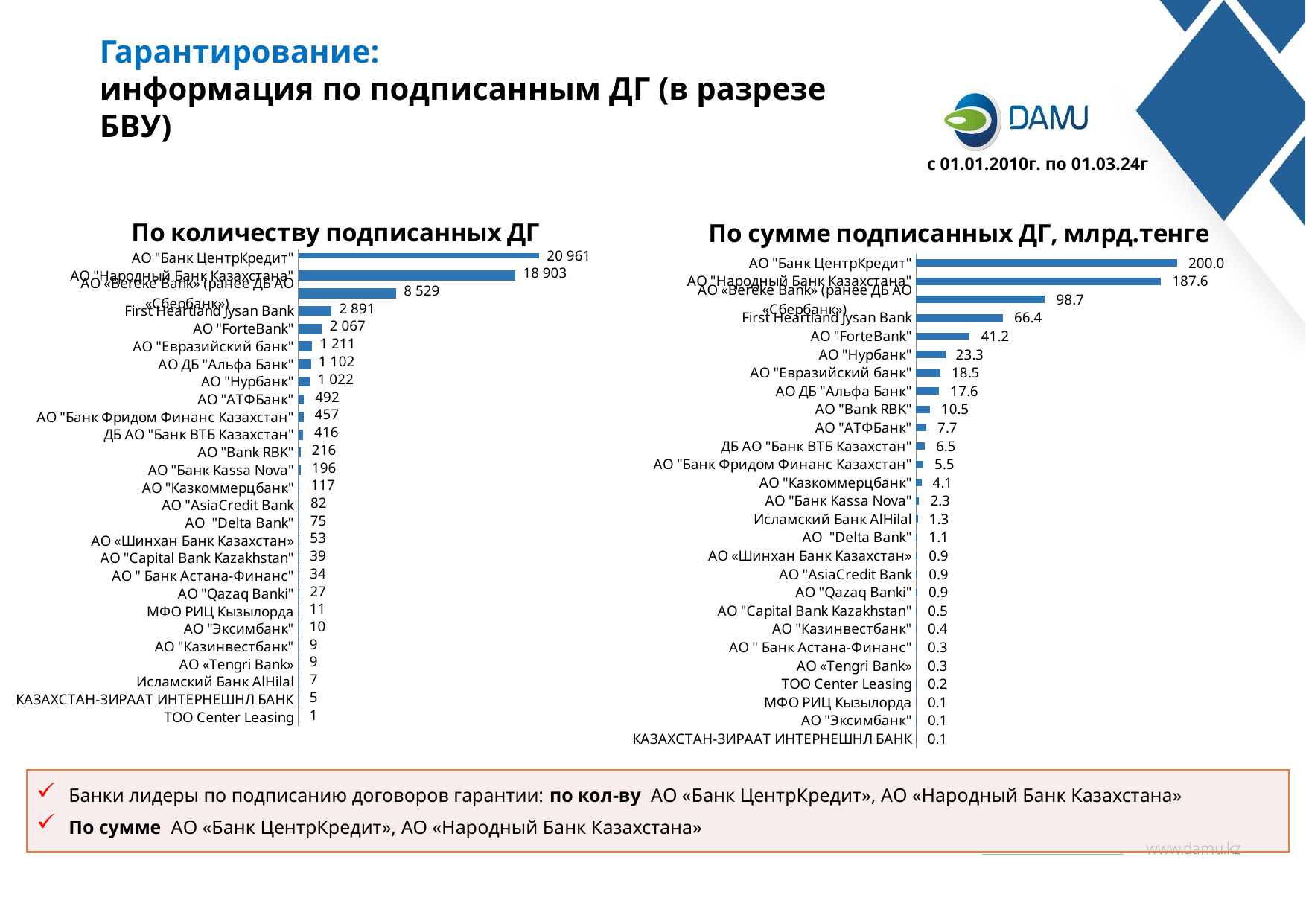
In the chart "По сумме подписанных ДГ, млрд.тенге", what is the difference between First Heartland Jysan Bank and АО "ForteBank"? 25.2 In the chart "По количеству подписанных ДГ", what is the value for АО "Bank RBK"? 216 In the chart "По сумме подписанных ДГ, млрд.тенге", which is larger: АО "Нурбанк" or АО "Евразийский банк"? АО "Нурбанк" What unit is stated in the title of the right-hand chart? млрд.тенге In the chart "По количеству подписанных ДГ", which category has the lowest value? ТОО Center Leasing In the chart "По количеству подписанных ДГ", what is the difference between АО "Банк ЦентрКредит" and АО "Народный Банк Казахстана"? 2 058 How many categories are shown in the chart "По количеству подписанных ДГ"? 27 In the chart "По сумме подписанных ДГ, млрд.тенге", what is the value for АО "Народный Банк Казахстана"? 187.6 In the chart "По количеству подписанных ДГ", what is the value for АО "Банк ЦентрКредит"? 20 961 In the chart "По сумме подписанных ДГ, млрд.тенге", which category has the highest value? АО "Банк ЦентрКредит" In the chart "По количеству подписанных ДГ", which is larger: АО "Евразийский банк" or АО ДБ "Альфа Банк"? АО "Евразийский банк" What type of chart is "По сумме подписанных ДГ, млрд.тенге"? Bar chart